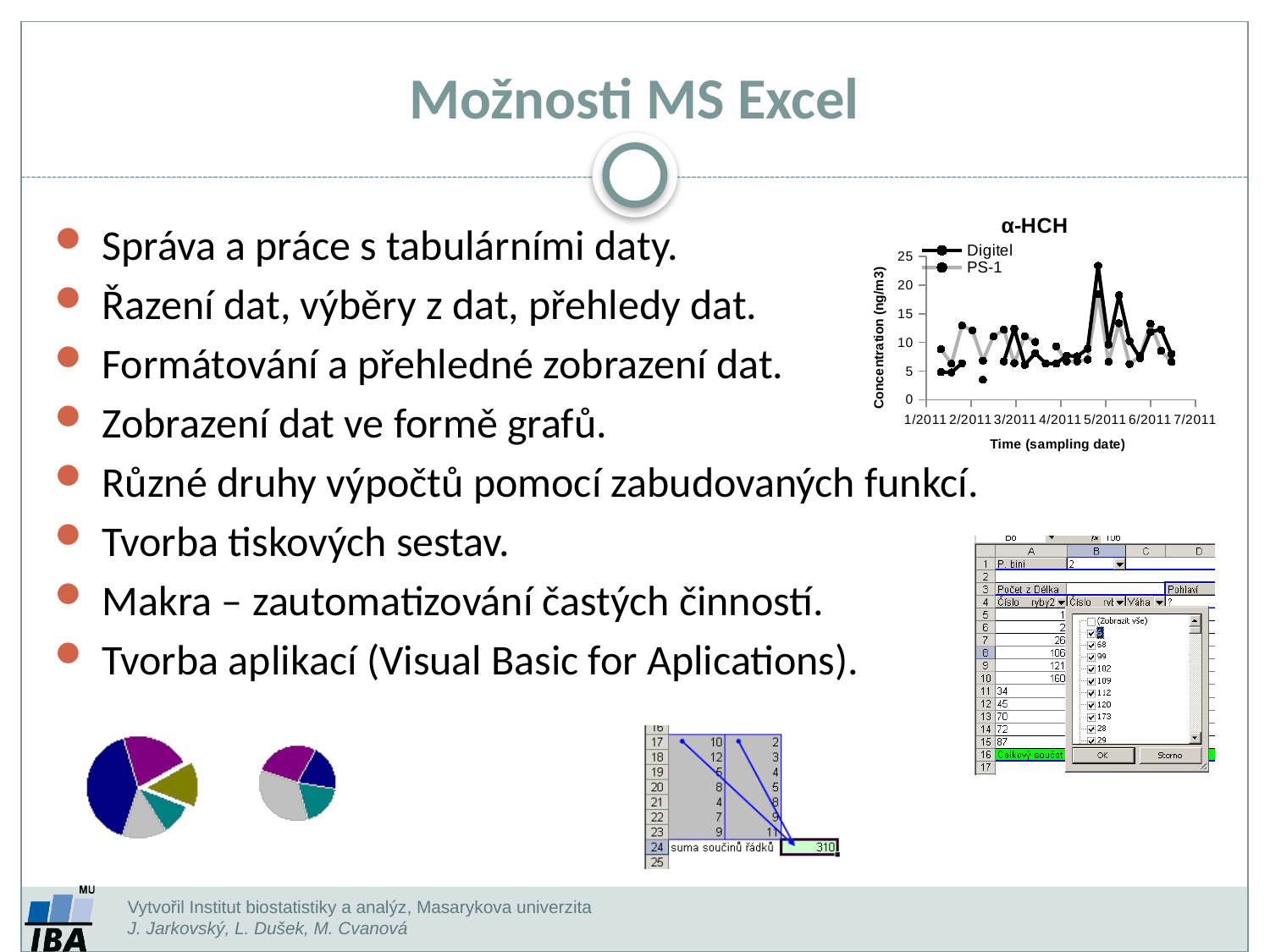
What are the two series named in the legend of the α-HCH chart? Digitel and PS-1 In the α-HCH chart, is the lowest PS-1 value greater or less than 5? greater In the α-HCH chart, is the highest value of the PS-1 series greater or less than 15? greater In the α-HCH chart, is the first Digitel value at 1/2011 greater or less than 10? less How many series does the legend of the α-HCH chart list? 2 What is the highest tick value shown on the y axis of the α-HCH chart? 25 What kind of chart is the α-HCH chart in the upper right of the slide? line chart How many date labels are shown on the x axis of the α-HCH chart? 7 In the α-HCH chart, which series reaches the higher peak around 5/2011, Digitel or PS-1? Digitel What kind of charts are the two charts in the lower left of the slide? pie charts What is the title of the line chart in the upper right of the slide? α-HCH